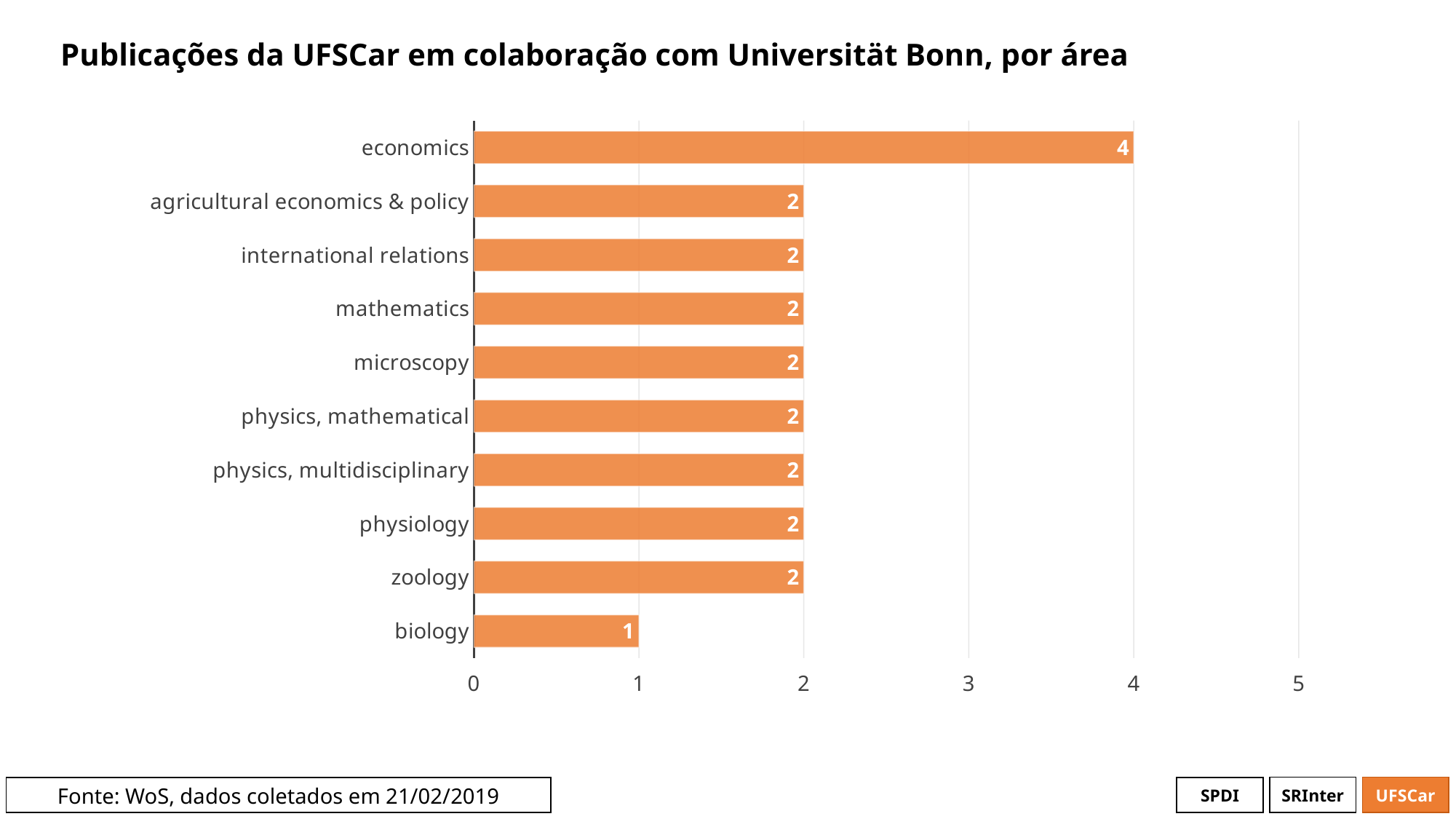
Which area has the lowest value? biology What kind of chart is shown on the slide? bar chart What is the difference between the values for economics and zoology? 2 How many areas have a value of 2? 8 What is the value for economics? 4 What is the value for biology? 1 Is the value for economics greater or less than 3? greater Which area has the highest value? economics What is the value for mathematics? 2 How many areas are shown in the chart? 10 What is the title of the chart? Publicações da UFSCar em colaboração com Universität Bonn, por área Which is larger, the value for physiology or the value for biology? physiology